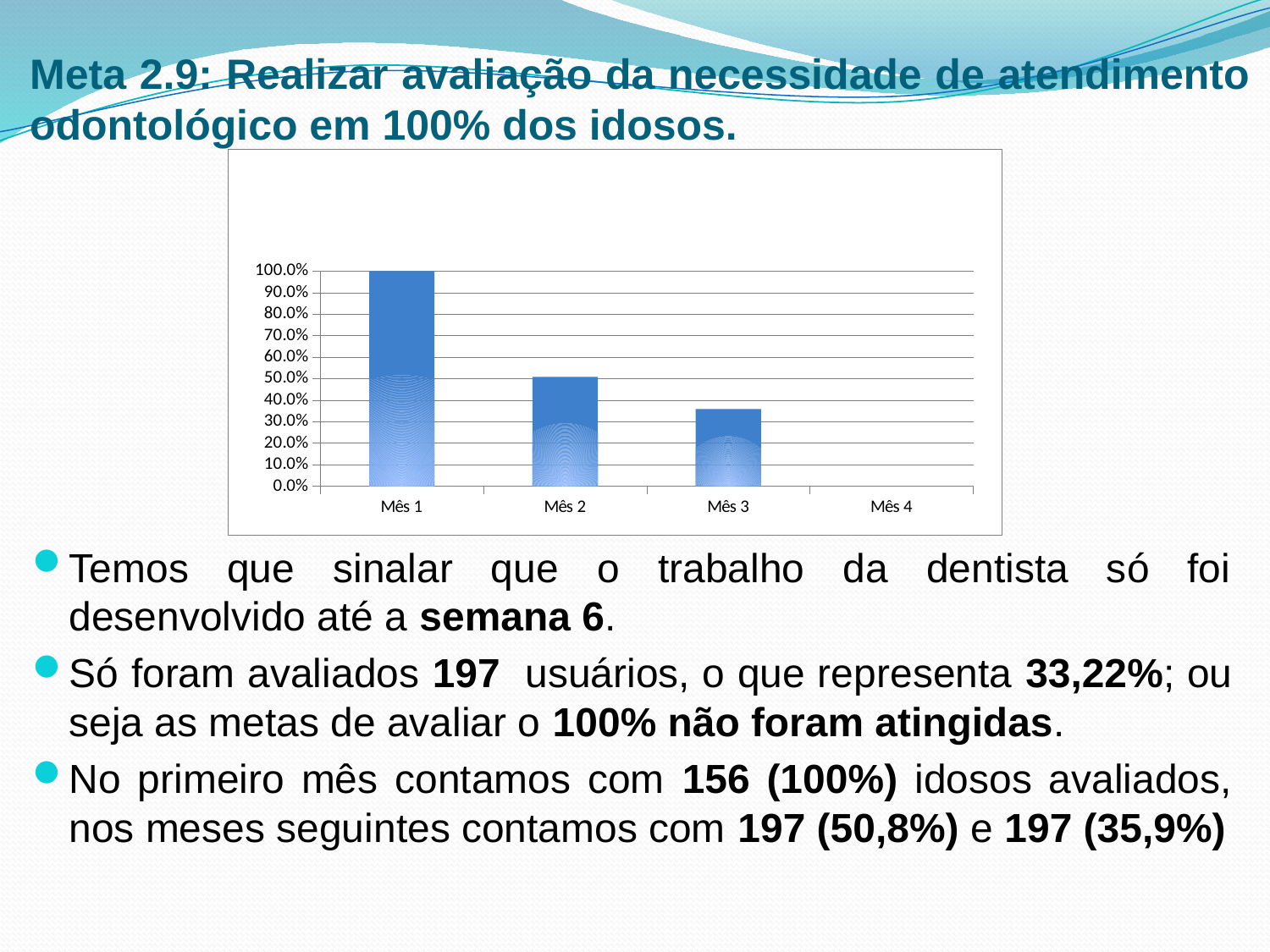
Do the values rise or fall from Mês 1 to Mês 3? fall Is the value for Mês 2 greater or less than 60.0%? less Is the value for Mês 3 greater or less than 40.0%? less How many months (categories) are shown on the x axis of the chart? 4 What kind of chart is shown on the slide? bar chart Which month has the highest value in the chart? Mês 1 What is the value for Mês 1 in the chart? 100.0% What is the highest tick value shown on the y axis of the chart? 100.0% Is the value for Mês 3 greater or less than 30.0%? greater Which is larger, the value for Mês 2 or the value for Mês 3? Mês 2 Which month on the x axis has no visible bar? Mês 4